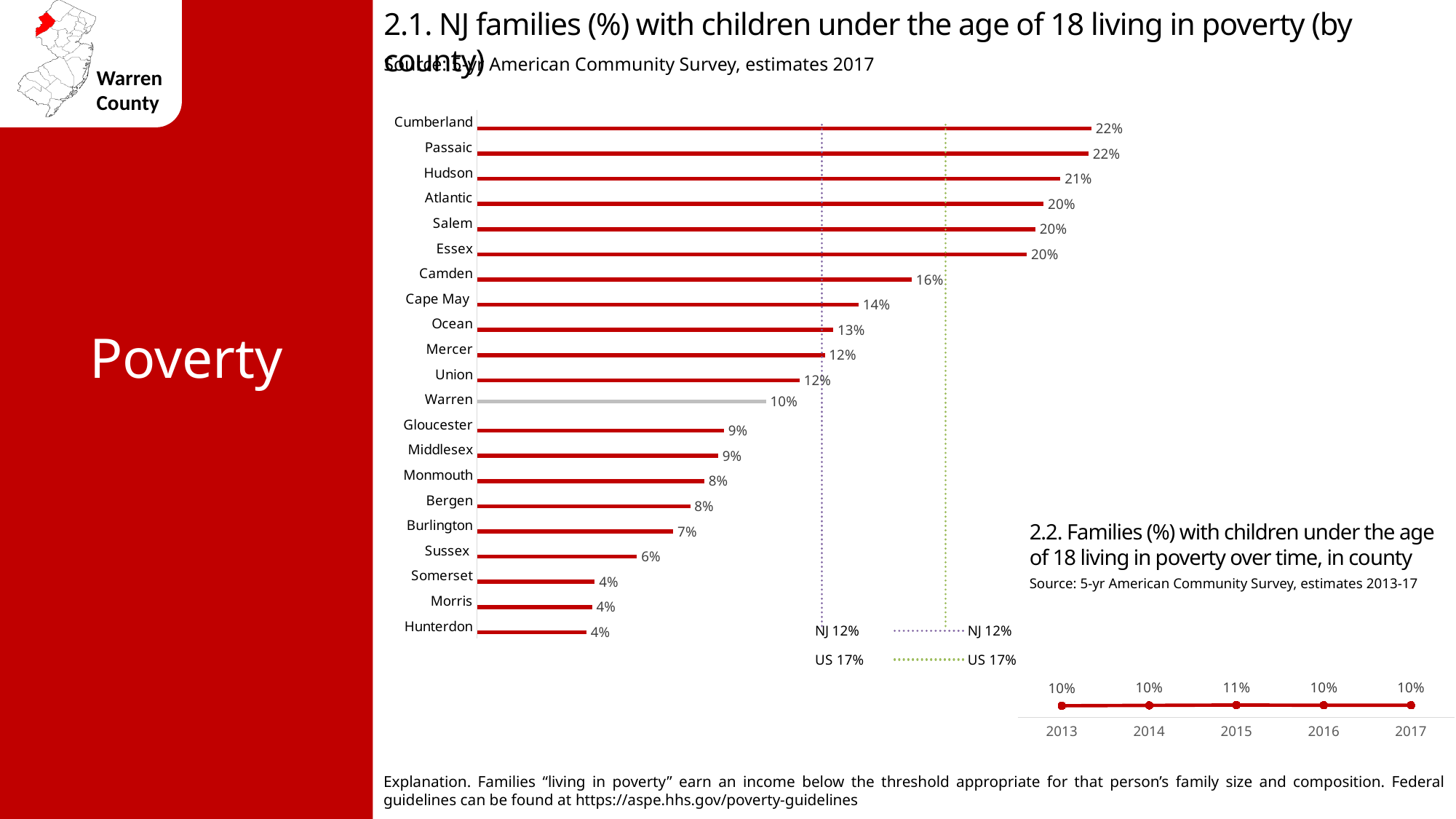
In chart 2.1, which is larger, the value for Cape May or the value for Ocean? Cape May What kind of chart is chart 2.1? Bar chart In chart 2.2, how many years are plotted? 5 In chart 2.1, what is the NJ reference value shown by the dotted line? 12% In chart 2.1, what is the value for Camden? 16% In chart 2.1 (NJ families with children under 18 living in poverty by county), what is the value for Warren? 10% In chart 2.1, how many counties are listed? 21 In chart 2.1, what is the difference between the values for Cumberland and Warren? 12% In chart 2.1, which county has the lowest value? Hunterdon, Morris and Somerset (tied at 4%) What kind of chart is chart 2.2? Line chart In chart 2.1, what is the US reference value shown by the dotted line? 17% In chart 2.2 (families with children under 18 living in poverty over time, in county), what is the value for 2015? 11%